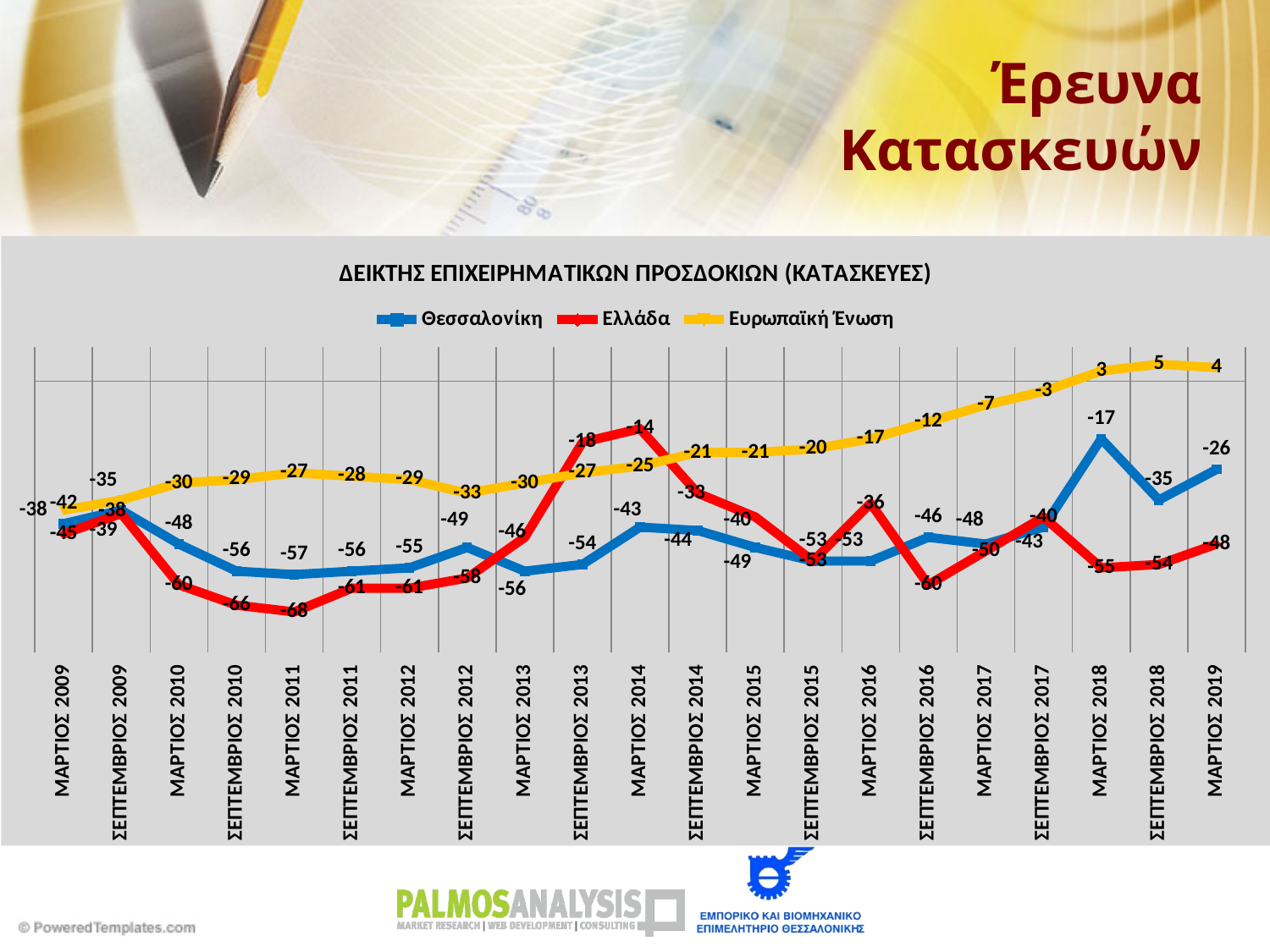
What is the difference between the Θεσσαλονίκη values in ΜΑΡΤΙΟΣ 2018 and ΣΕΠΤΕΜΒΡΙΟΣ 2018? 18 What is the value for Ευρωπαϊκή Ένωση in ΜΑΡΤΙΟΣ 2019? 4 How many series does the legend list? 3 What type of chart is shown on the slide? Line chart In which period does the Ελλάδα series reach its highest value? ΜΑΡΤΙΟΣ 2014 What is the value for Ελλάδα in ΜΑΡΤΙΟΣ 2011? -68 How many time points are plotted along the x axis? 21 Does the Ευρωπαϊκή Ένωση series generally rise or fall from ΜΑΡΤΙΟΣ 2009 to ΜΑΡΤΙΟΣ 2019? Rise In which period does the Ευρωπαϊκή Ένωση series reach its highest value? ΣΕΠΤΕΜΒΡΙΟΣ 2018 In ΜΑΡΤΙΟΣ 2019, which is higher: Θεσσαλονίκη or Ελλάδα? Θεσσαλονίκη In which period does the Ελλάδα series reach its lowest value? ΜΑΡΤΙΟΣ 2011 What is the value for Θεσσαλονίκη in ΜΑΡΤΙΟΣ 2018? -17